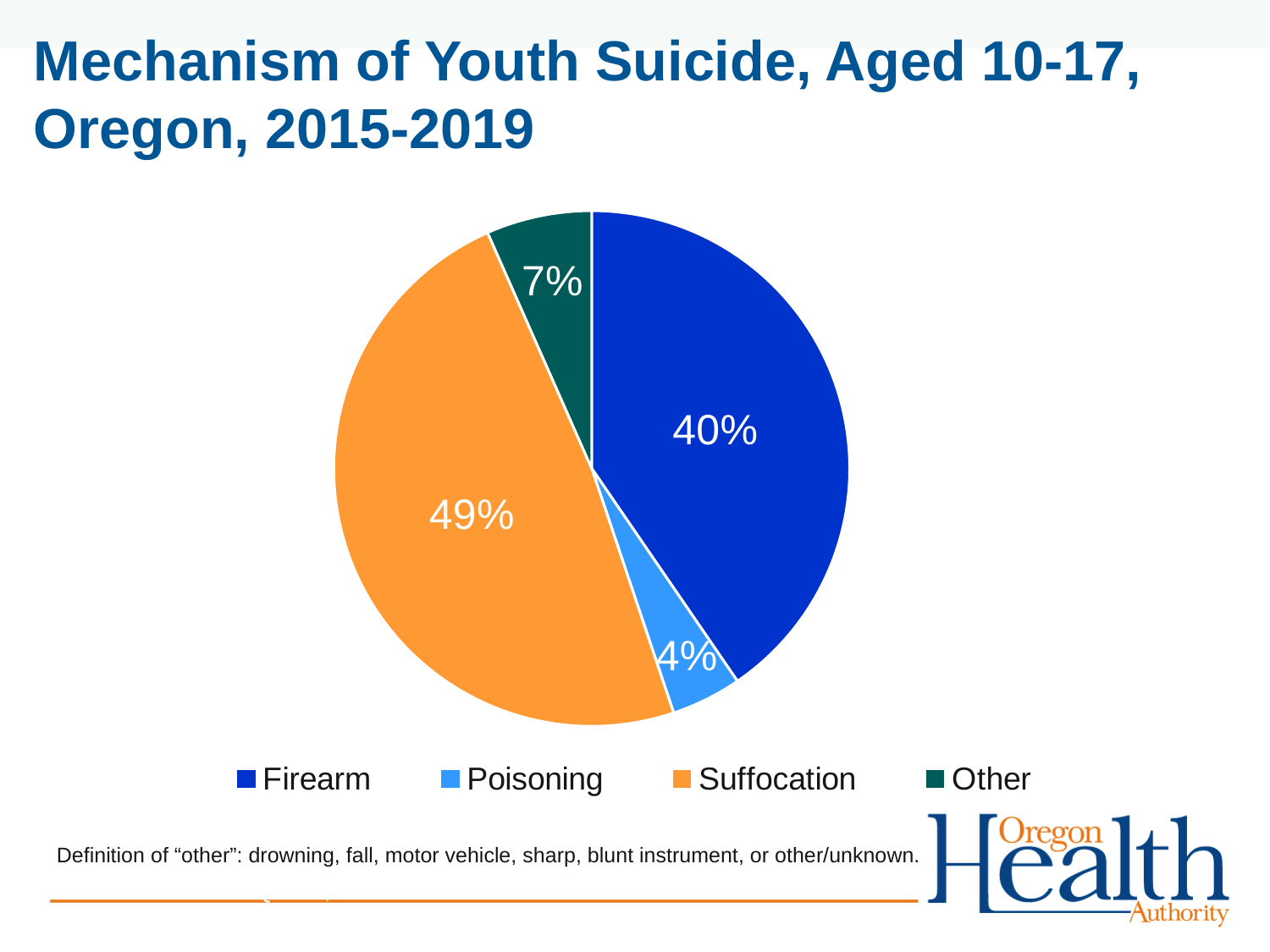
Which is larger, the share for Other or the share for Poisoning? Other What kind of chart is shown on the slide? Pie chart Which mechanism has the largest share of the pie? Suffocation What share of the pie does Poisoning account for? 4% What share of the pie does Suffocation account for? 49% What is the difference in percentage points between the Suffocation and Firearm shares? 9 What share of the pie does Firearm account for? 40% Which mechanism has the smallest share of the pie? Poisoning Which category is shown in orange in the legend? Suffocation What is the title of the chart? Mechanism of Youth Suicide, Aged 10-17, Oregon, 2015-2019 How many categories does the pie chart show? 4